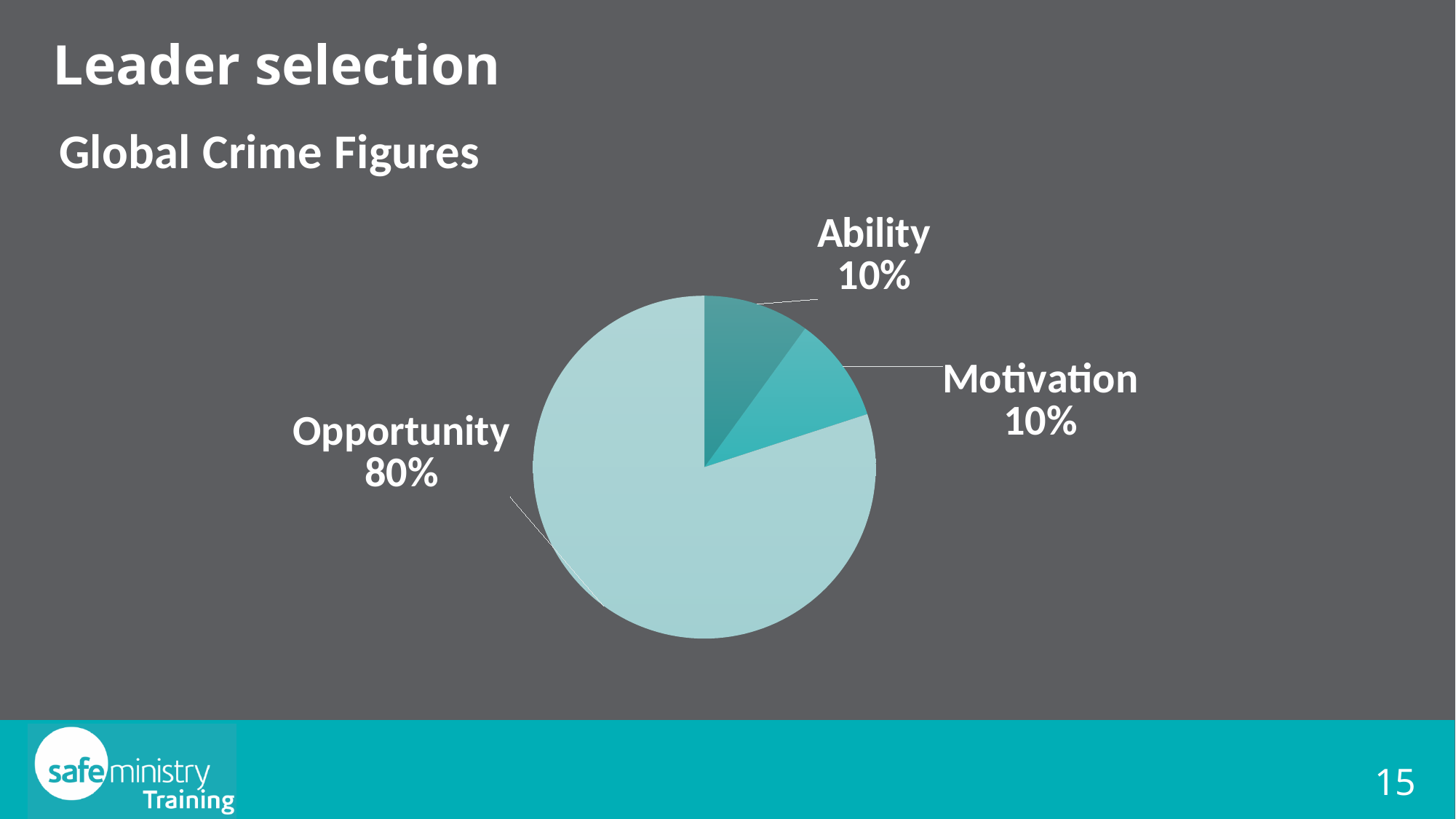
Which slice of the pie is the largest? Opportunity Is the Opportunity slice greater or less than half of the pie? greater What is the combined share of Ability and Motivation? 20% What is the title shown above the pie chart? Global Crime Figures Which is larger, the Opportunity slice or the Motivation slice? Opportunity What kind of chart is shown on the slide? pie chart What share of the pie does Ability represent? 10% How many slices does the pie chart have? 3 What is the difference between the Opportunity share and the Ability share? 70% What share of the pie does Motivation represent? 10% What share of the pie does Opportunity represent? 80%